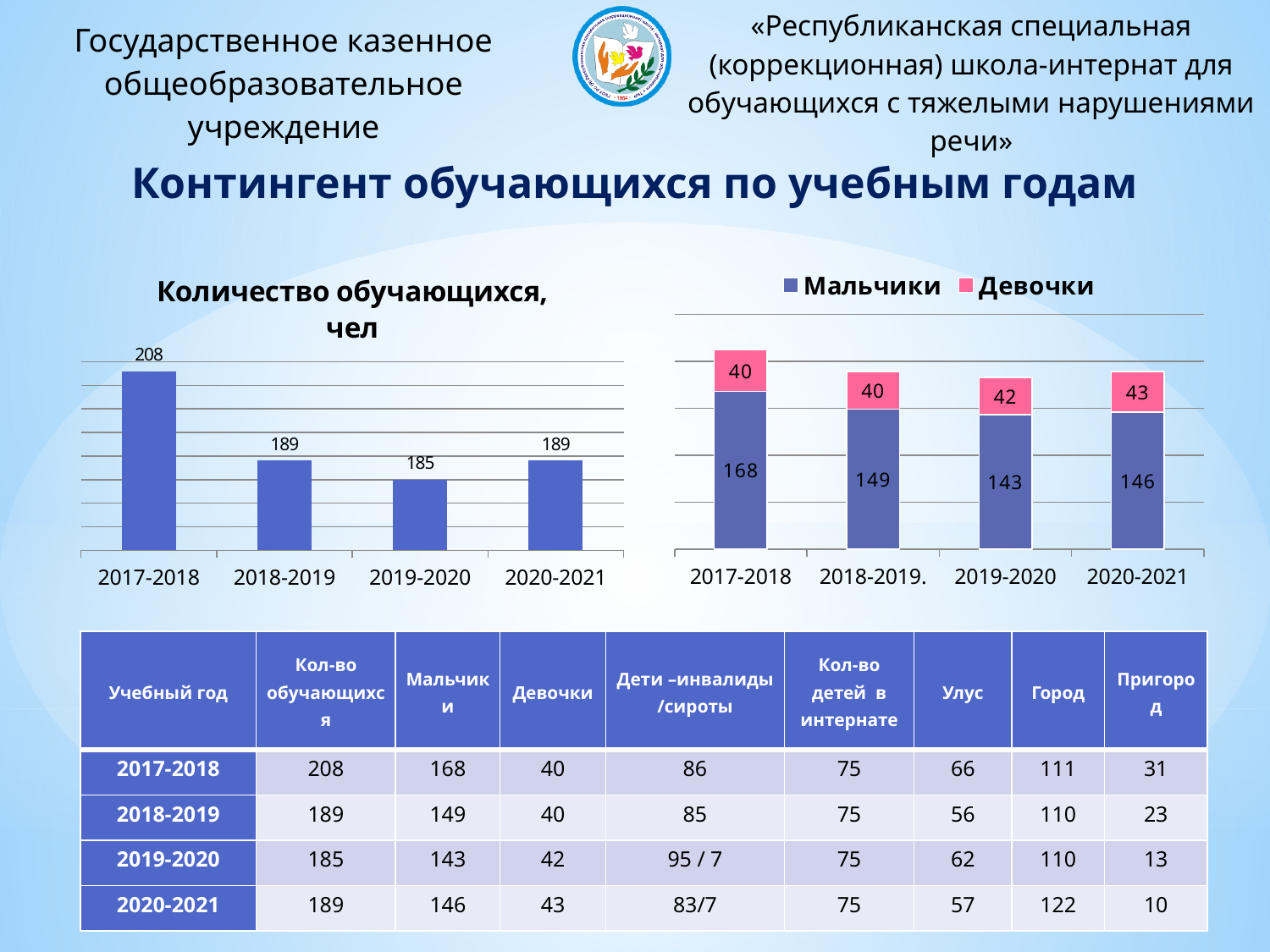
In the stacked bar chart on the right, which colour represents Девочки? pink In the chart titled "Количество обучающихся, чел", what is the difference between the values for 2017-2018 and 2019-2020? 23 In the stacked bar chart on the right, what is the value for Девочки in 2020-2021? 43 In the chart titled "Количество обучающихся, чел", what is the value for 2017-2018? 208 In the stacked bar chart on the right, is the value for Мальчики larger in 2017-2018 or in 2020-2021? 2017-2018 In the chart titled "Количество обучающихся, чел", which year has the lowest value? 2019-2020 What kind of chart is the chart titled "Количество обучающихся, чел"? bar chart In the stacked bar chart on the right, how many series does the legend list? 2 In the stacked bar chart on the right, what is the total of the stacked bar for 2019-2020? 185 In the chart titled "Количество обучающихся, чел", which year has the highest value? 2017-2018 In the stacked bar chart on the right, what is the value for Мальчики in 2018-2019? 149 In the chart titled "Количество обучающихся, чел", how many years are shown on the x axis? 4